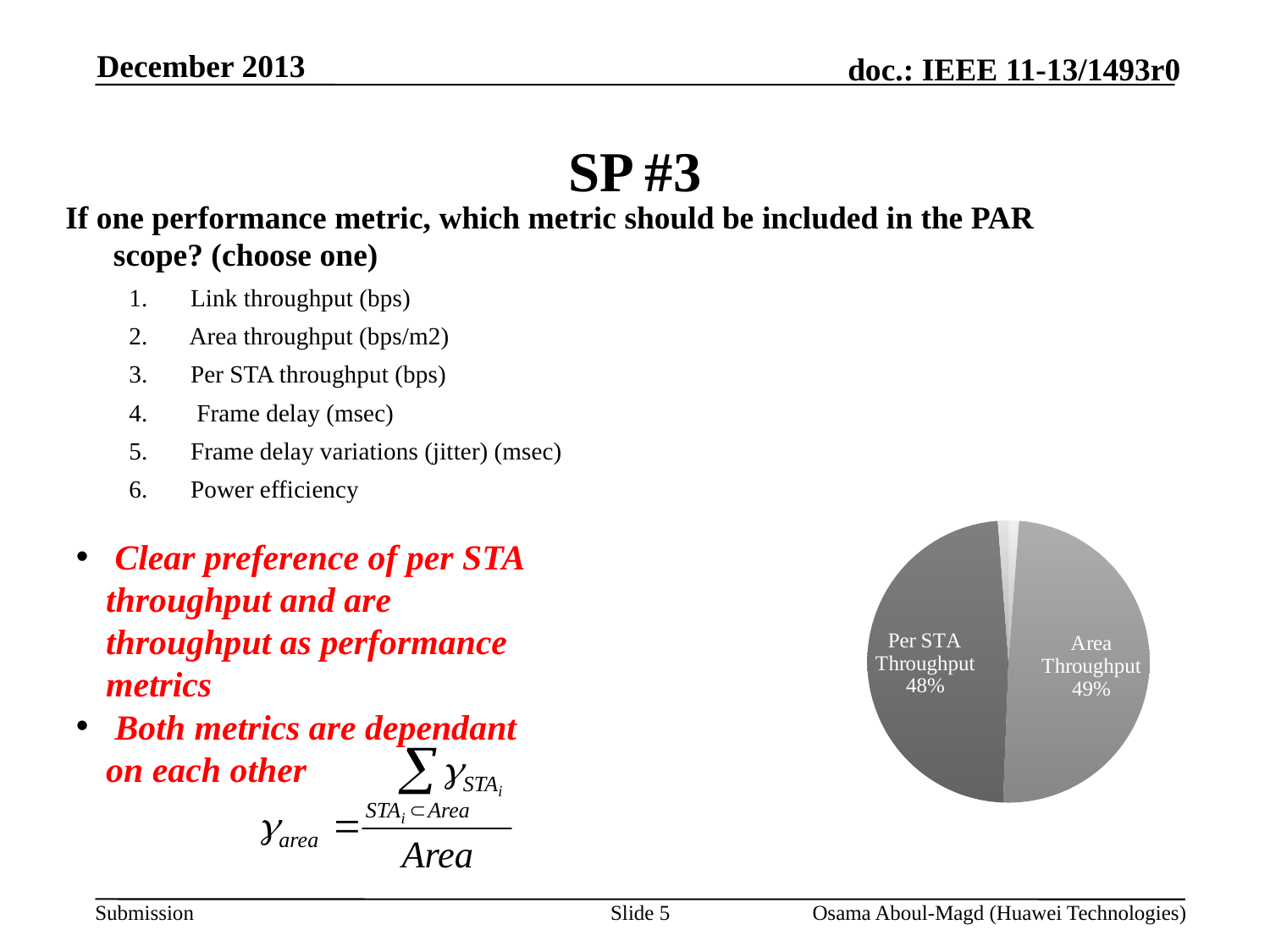
Is the share for Per STA Throughput greater or less than 50%? less What share of the pie does Area Throughput have? 49% How many slices of the pie have a printed label? 2 What share of the pie does Per STA Throughput have? 48% What is the difference in percentage points between the Area Throughput and Per STA Throughput slices? 1% What is the value shown for the Area Throughput slice? 49% What is the value shown for the Per STA Throughput slice? 48% Which has the larger share, Area Throughput or Per STA Throughput? Area Throughput What kind of chart is shown on the slide? pie chart Which labelled slice of the pie is the largest? Area Throughput